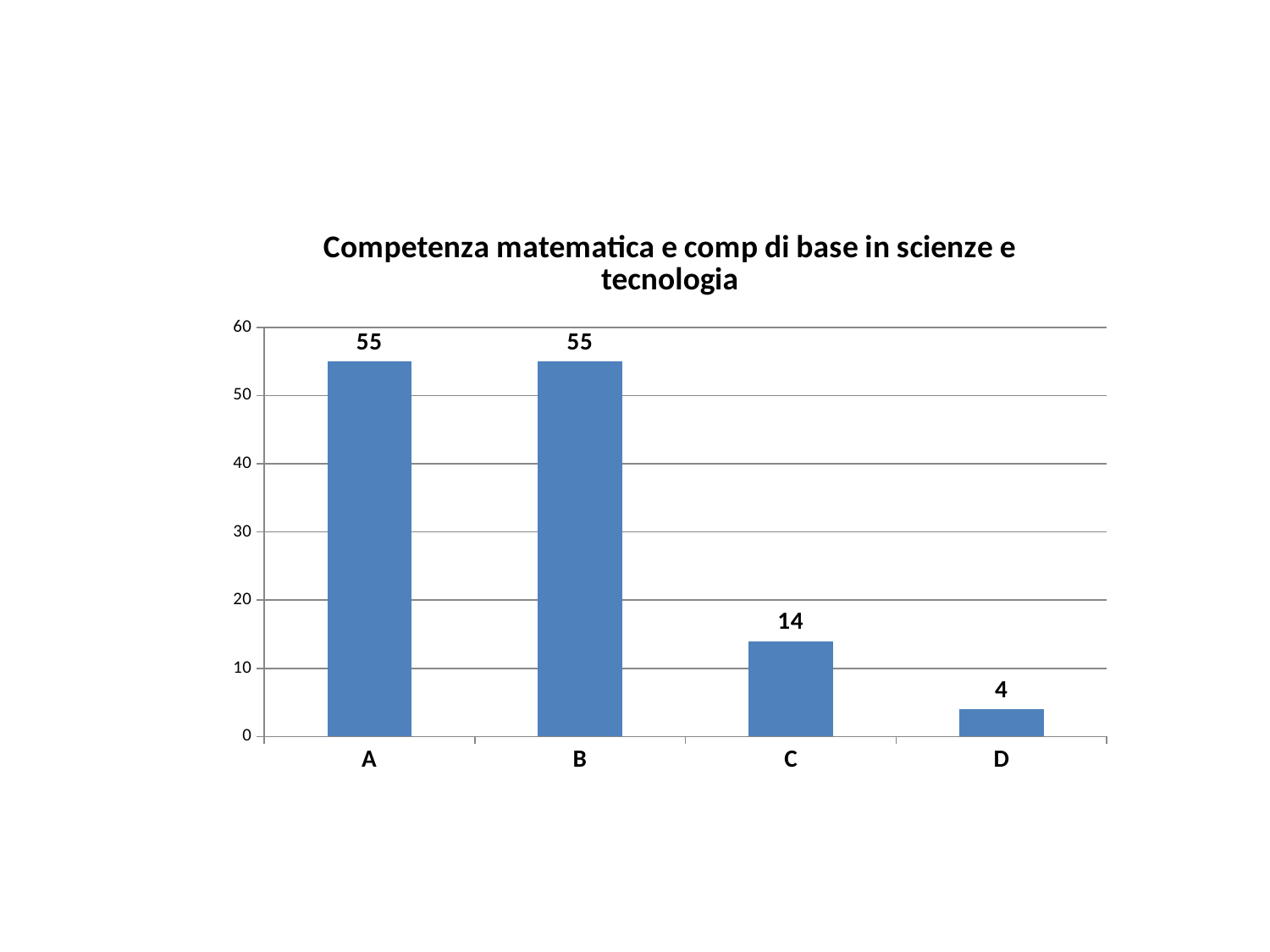
Which is larger, the value for C or the value for D? C What kind of chart is shown on the slide? bar chart What is the difference between the values for C and D? 10 What is the value for category D? 4 What is the value for category C? 14 How many categories are shown on the x axis? 4 Which category has the lowest value? D What is the title of the chart? Competenza matematica e comp di base in scienze e tecnologia What is the value for category A? 55 Is the value for C greater or less than 20? less Do the values rise or fall from A to D along the x axis? fall What is the difference between the values for B and C? 41